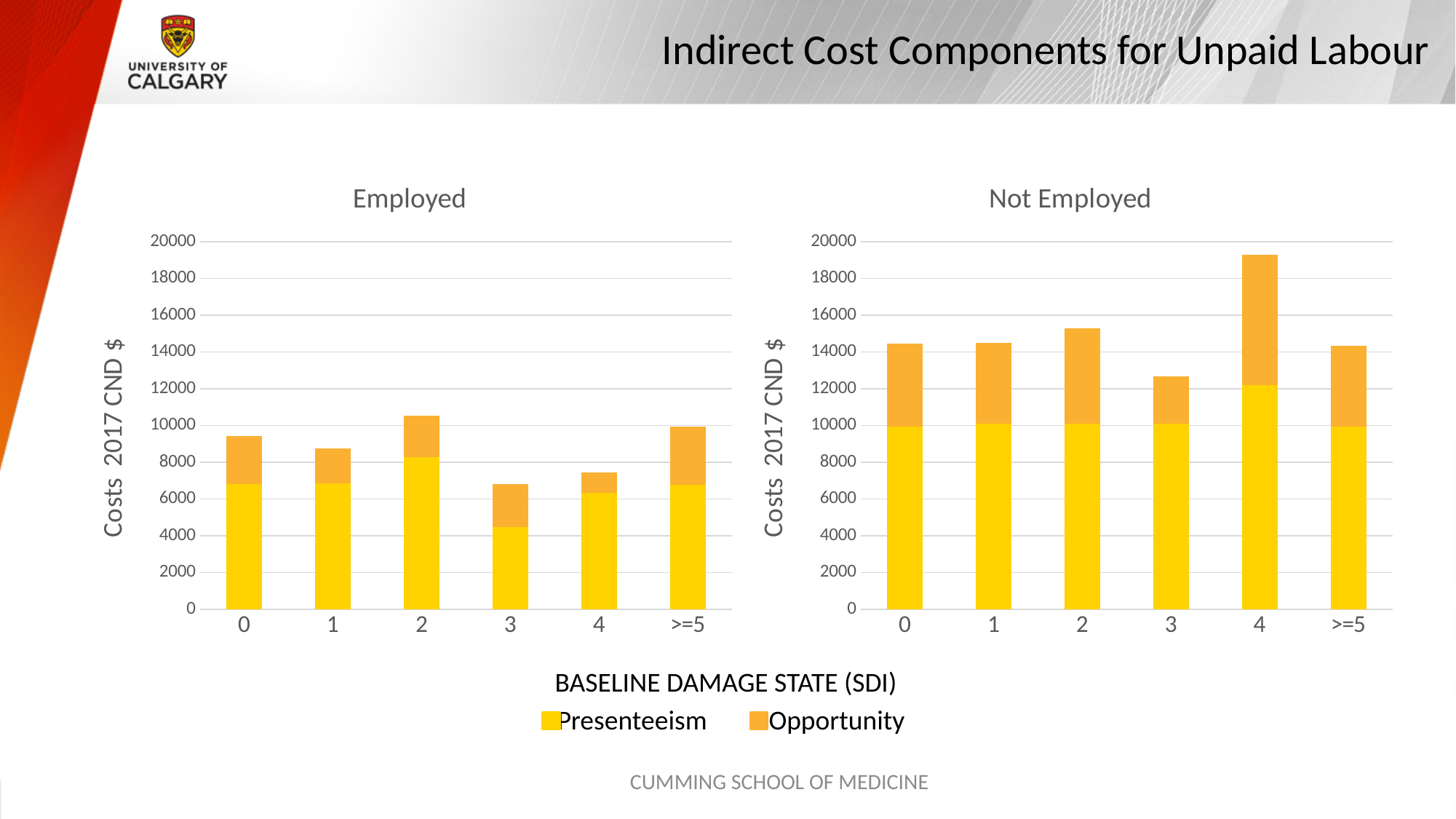
What kind of chart is the Employed chart? stacked bar chart In the Employed chart, which baseline damage state has the lowest total cost? 3 How many series does the legend list? 2 In the Not Employed chart, which baseline damage state has the highest total cost? 4 In the Employed chart, is the Presenteeism value for damage state 3 greater or less than 6000? less In the Not Employed chart, is the total cost for damage state 4 greater or less than 18000? greater In the Not Employed chart, which has the larger total cost: damage state 4 or damage state 0? 4 What is the x-axis title shared by the two charts? BASELINE DAMAGE STATE (SDI) How many baseline damage state categories are shown on the Not Employed chart? 6 In the Employed chart, which baseline damage state has the highest total cost? 2 In the Not Employed chart, which baseline damage state has the lowest total cost? 3 In the Employed chart, is the total cost for damage state 2 greater or less than 10000? greater